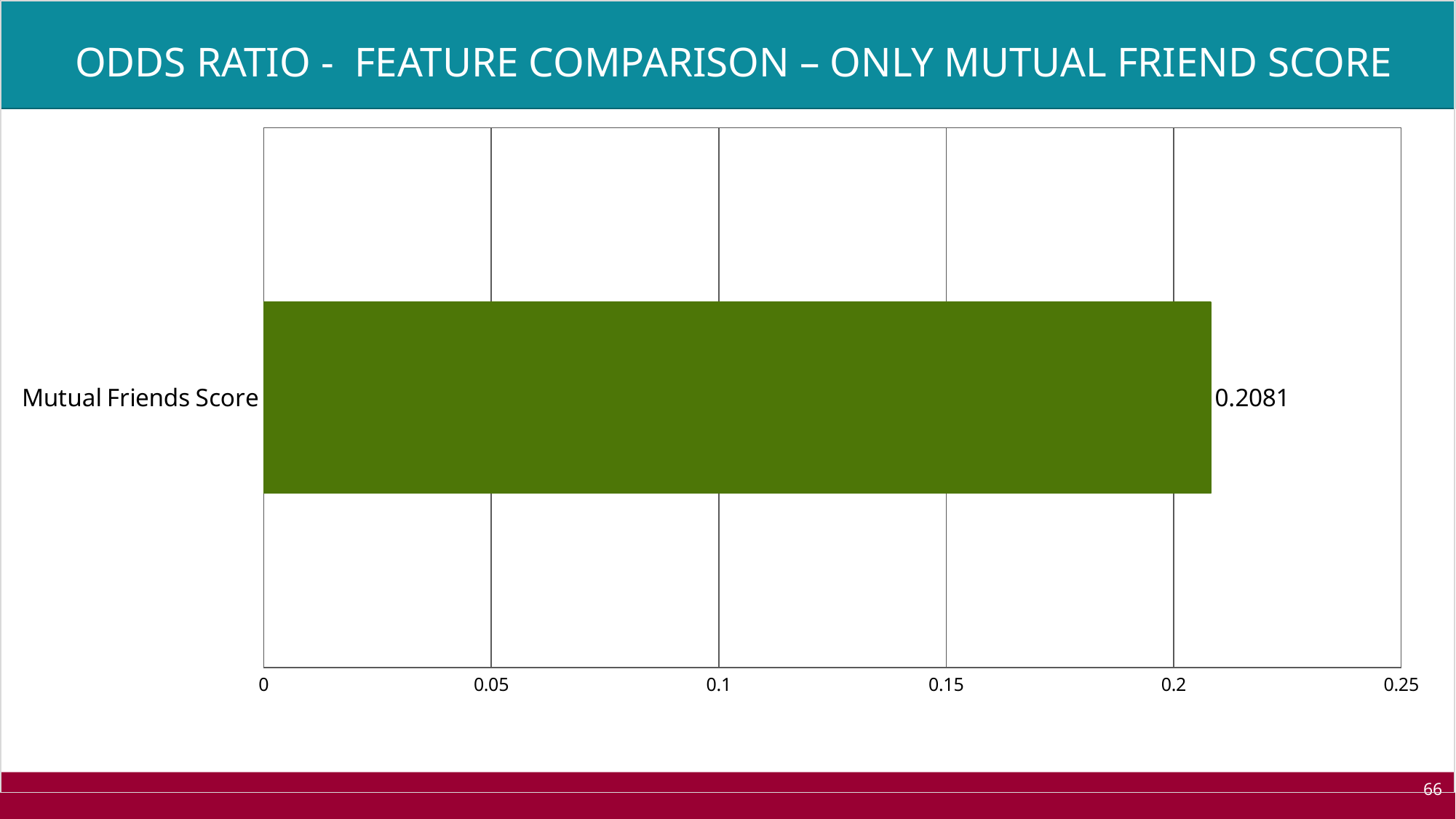
What kind of chart is shown on the slide? bar chart What is the maximum value shown on the x axis? 0.25 Is the value for Mutual Friends Score greater or less than 0.2? greater What is the label of the only category shown in the chart? Mutual Friends Score What is the value for Mutual Friends Score? 0.2081 Is the value for Mutual Friends Score greater or less than 0.25? less How many categories are plotted in the chart? 1 Is the value for Mutual Friends Score greater or less than 0.15? greater